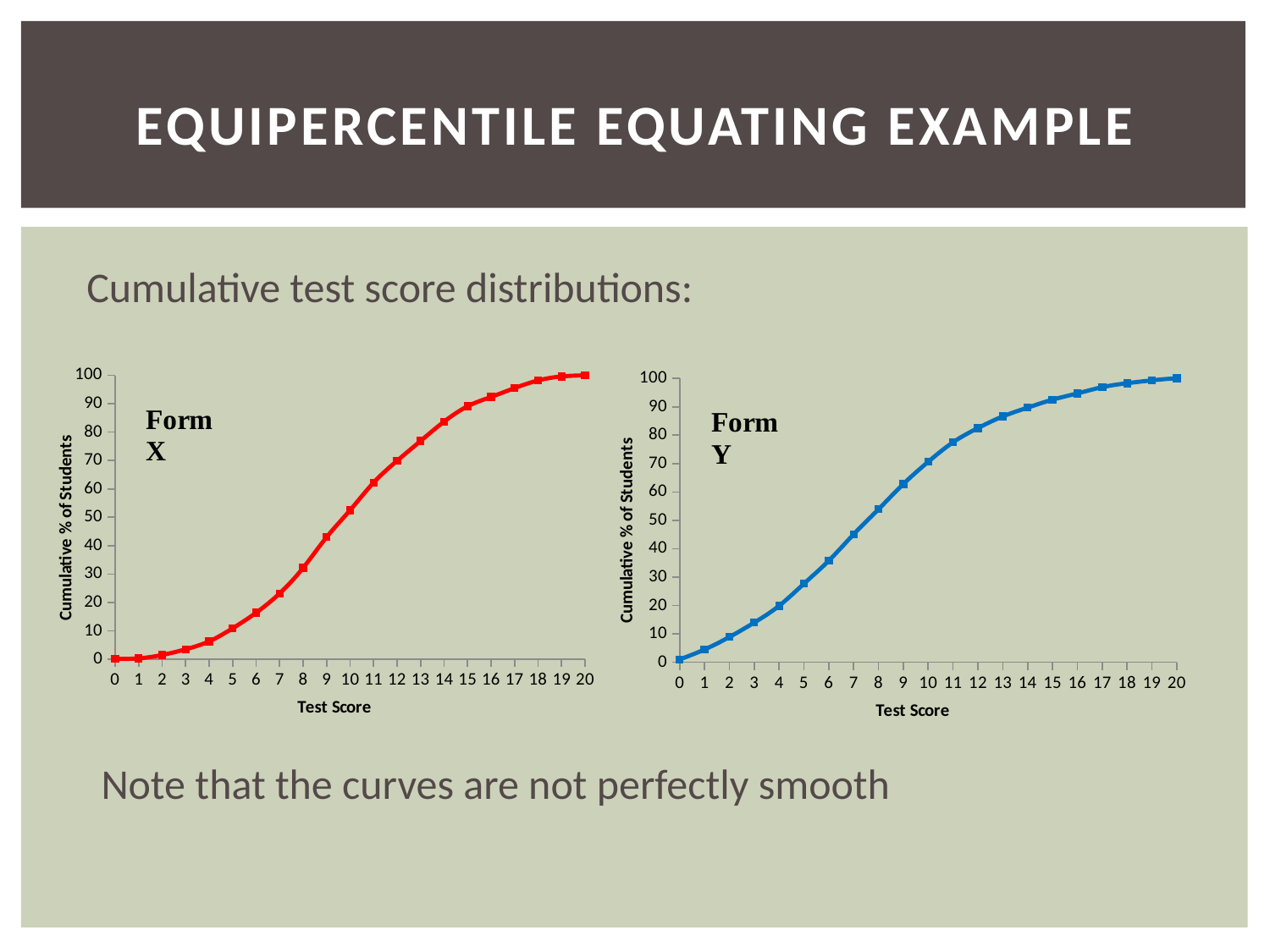
What is the y-axis title of the Form Y chart? Cumulative % of Students In the Form X chart, at which test score is the cumulative % of students lowest? 0 In the Form X chart, is the value at a test score of 14 greater or less than 80? greater In the Form X chart, is the value at a test score of 10 greater or less than 50? greater At a test score of 5, which form has the higher cumulative % of students, Form X or Form Y? Form Y In the Form X chart, how many test score points are plotted along the x axis? 21 What kind of chart is the Form X chart on the left? line chart In the Form X chart, what is the cumulative % of students at a test score of 20? 100 In the Form Y chart, at which test score is the cumulative % of students highest? 20 In the Form Y chart, is the value at a test score of 7 greater or less than 50? less What colour is the line in the Form X chart? red In the Form Y chart, do the values rise or fall as the test score increases? rise